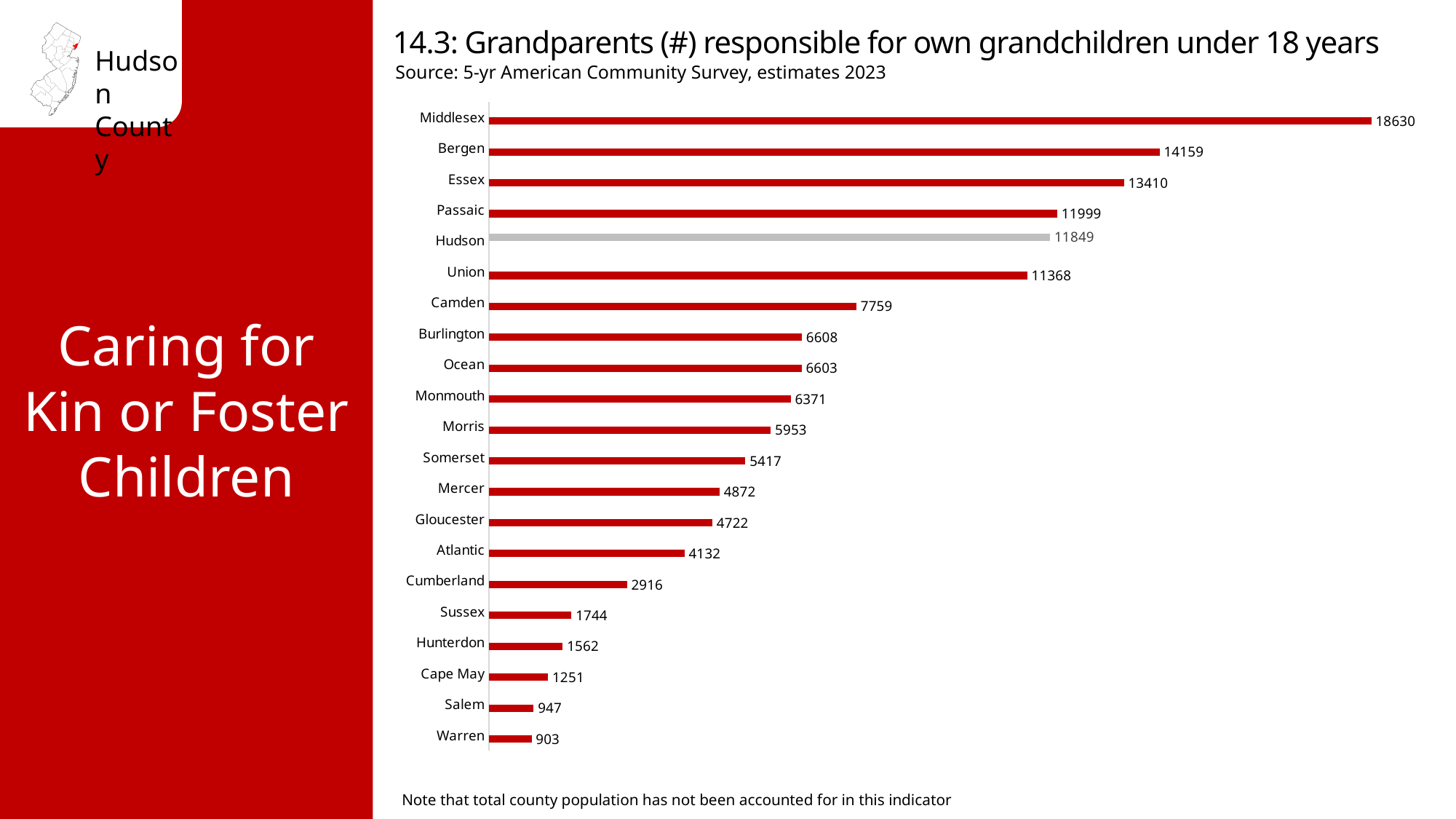
What is the difference between the values for Passaic and Hudson? 150 How many counties are shown in the chart? 21 What is the value for Cape May? 1251 What is the value for Hudson? 11849 What is the difference between the values for Middlesex and Bergen? 4471 What kind of chart is this? Bar chart Which county has the lowest value? Warren Which county's bar is shown in grey rather than red? Hudson Which county has the highest value? Middlesex Which is larger, the value for Essex or the value for Union? Essex What is the value for Camden? 7759 What is the source cited under the chart title? 5-yr American Community Survey, estimates 2023